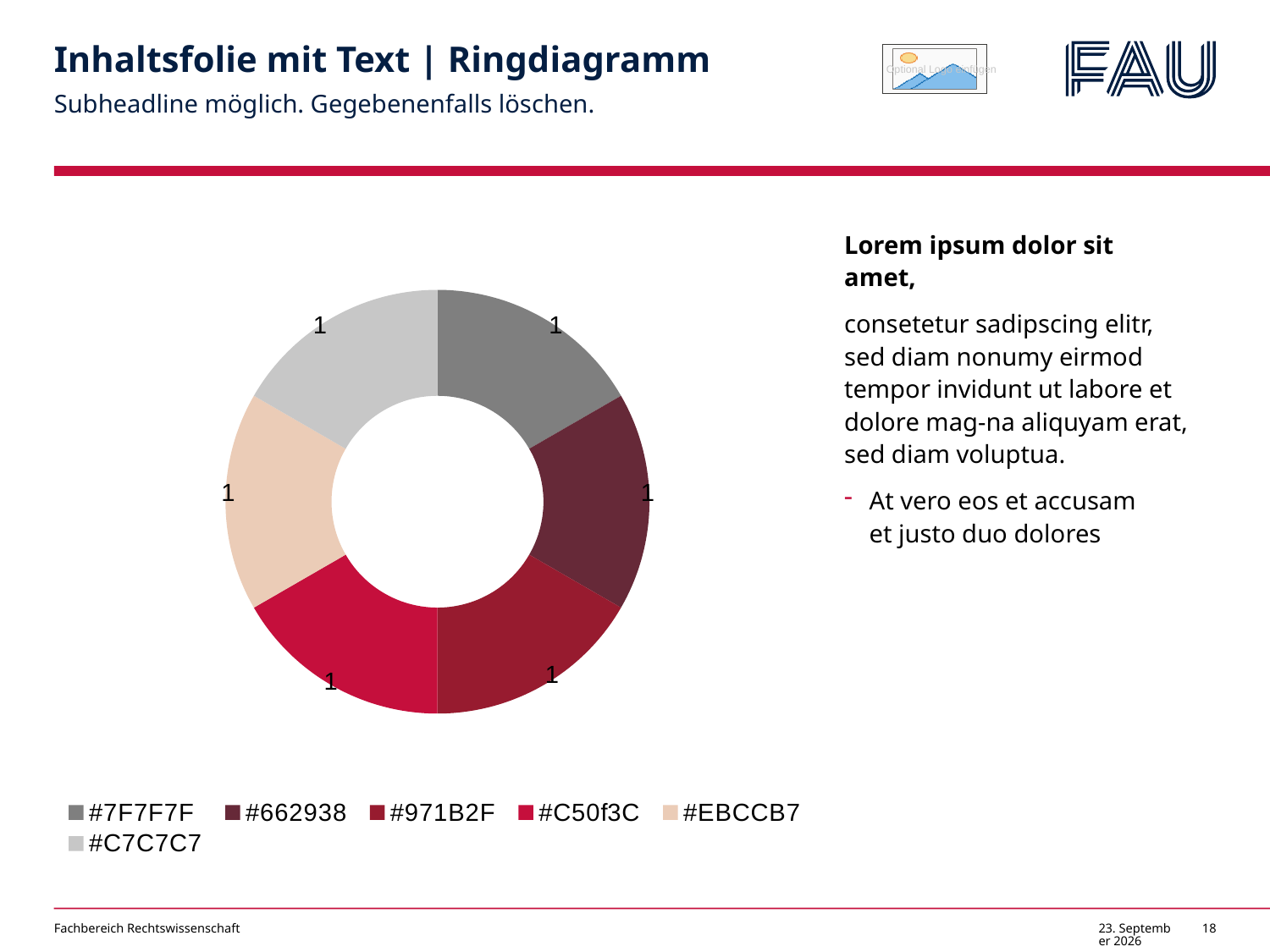
What kind of chart is shown on the slide? doughnut chart What is the value of the #C7C7C7 segment in the doughnut chart? 1 What is the difference between the values of the #7F7F7F and #C7C7C7 segments? 0 What is the value of the #EBCCB7 segment in the doughnut chart? 1 What is the value of the #662938 segment in the doughnut chart? 1 How many entries does the legend of the doughnut chart list? 6 What is the value of the #7F7F7F segment in the doughnut chart? 1 How many segments does the doughnut chart have? 6 Which legend entry is shown in the lightest grey colour? #C7C7C7 What is the value of the #971B2F segment in the doughnut chart? 1 What is the total of all segment values in the doughnut chart? 6 What is the value of the #C50f3C segment in the doughnut chart? 1